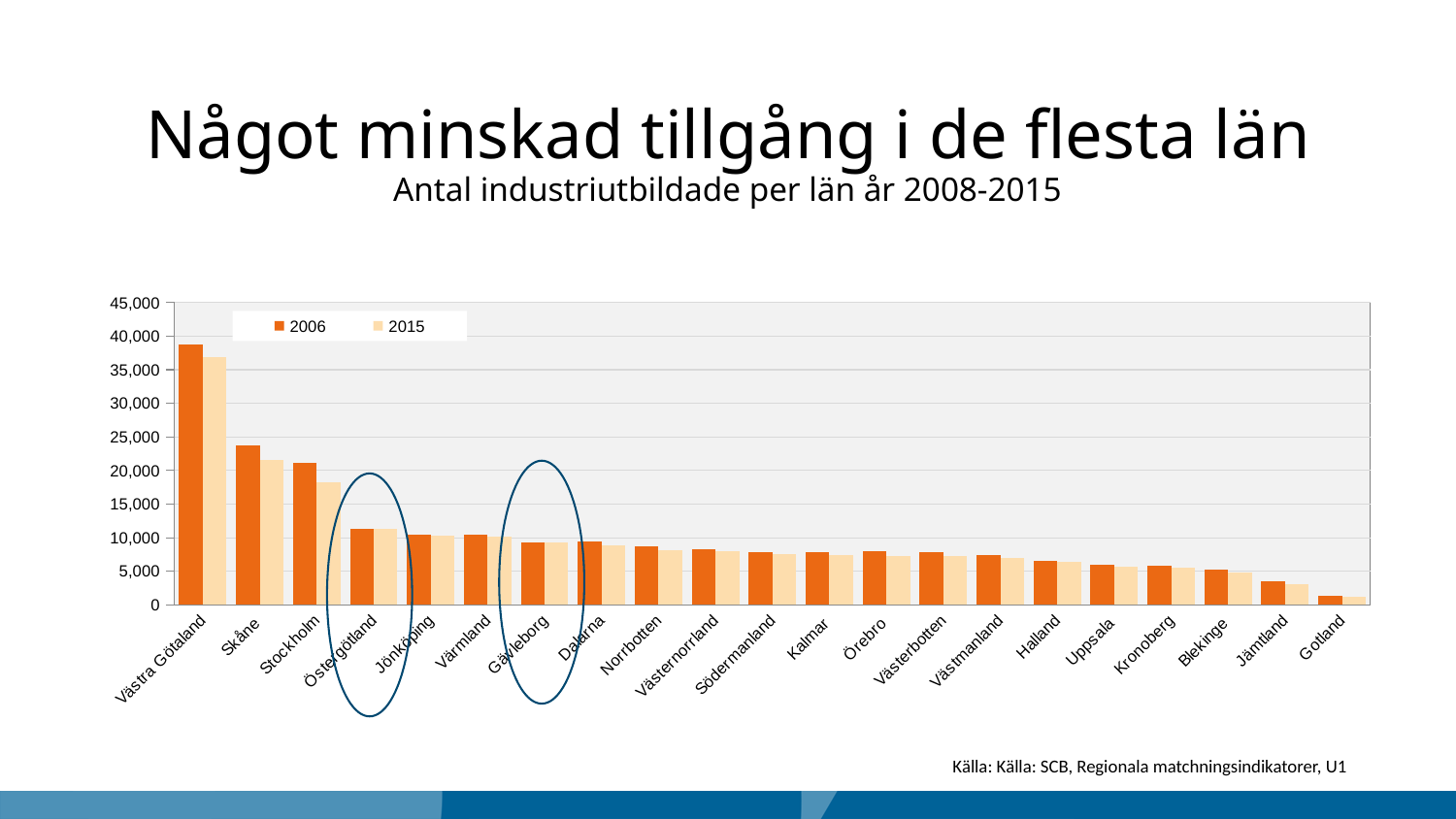
Is the 2015 value for Stockholm greater or less than 20,000? less What kind of chart is shown on the slide? bar chart Do the 2006 values generally rise or fall moving from left to right along the x axis? fall Which is larger, the 2006 value for Skåne or the 2006 value for Stockholm? Skåne Is the 2006 value for Västra Götaland greater or less than 35,000? greater Is the 2006 value for Skåne greater or less than 20,000? greater Which two years are listed in the chart legend? 2006 and 2015 How many counties (län) are shown on the x axis? 21 How many series does the legend list? 2 Which county has the lowest value for 2015? Gotland Which county has the highest value for 2006? Västra Götaland